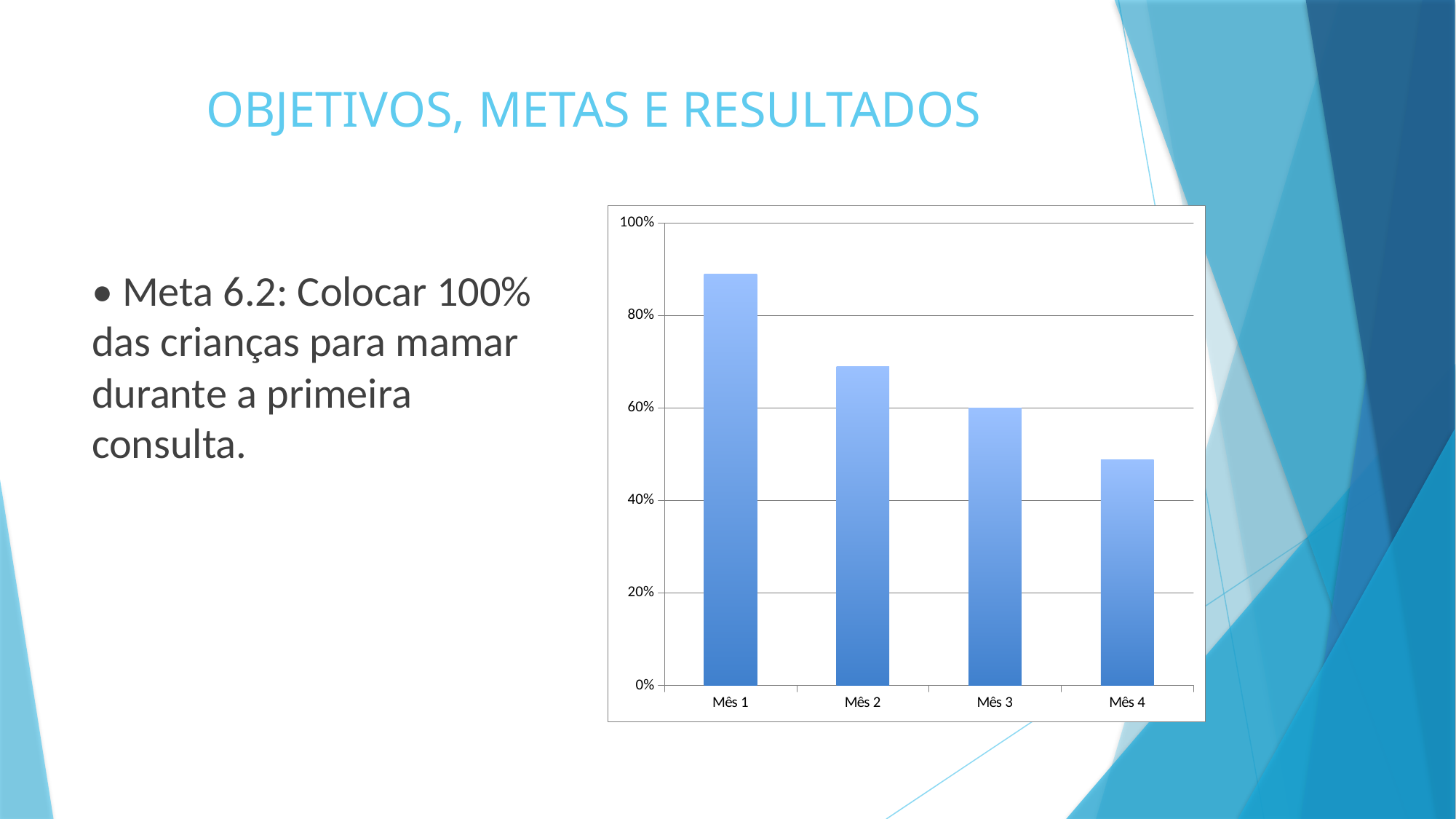
What kind of chart is shown on the slide? bar chart Is the value for Mês 1 greater or less than 80%? greater Which is larger, the value for Mês 2 or the value for Mês 3? Mês 2 Is the value for Mês 2 greater or less than 60%? greater Which month has the lowest bar in the chart? Mês 4 How many categories are plotted on the x axis of the chart? 4 Do the values rise or fall from Mês 1 to Mês 4? fall Which month has the highest bar in the chart? Mês 1 Is the value for Mês 4 greater or less than 40%? greater Which is larger, the value for Mês 1 or the value for Mês 4? Mês 1 What is the highest tick label shown on the y axis of the chart? 100%